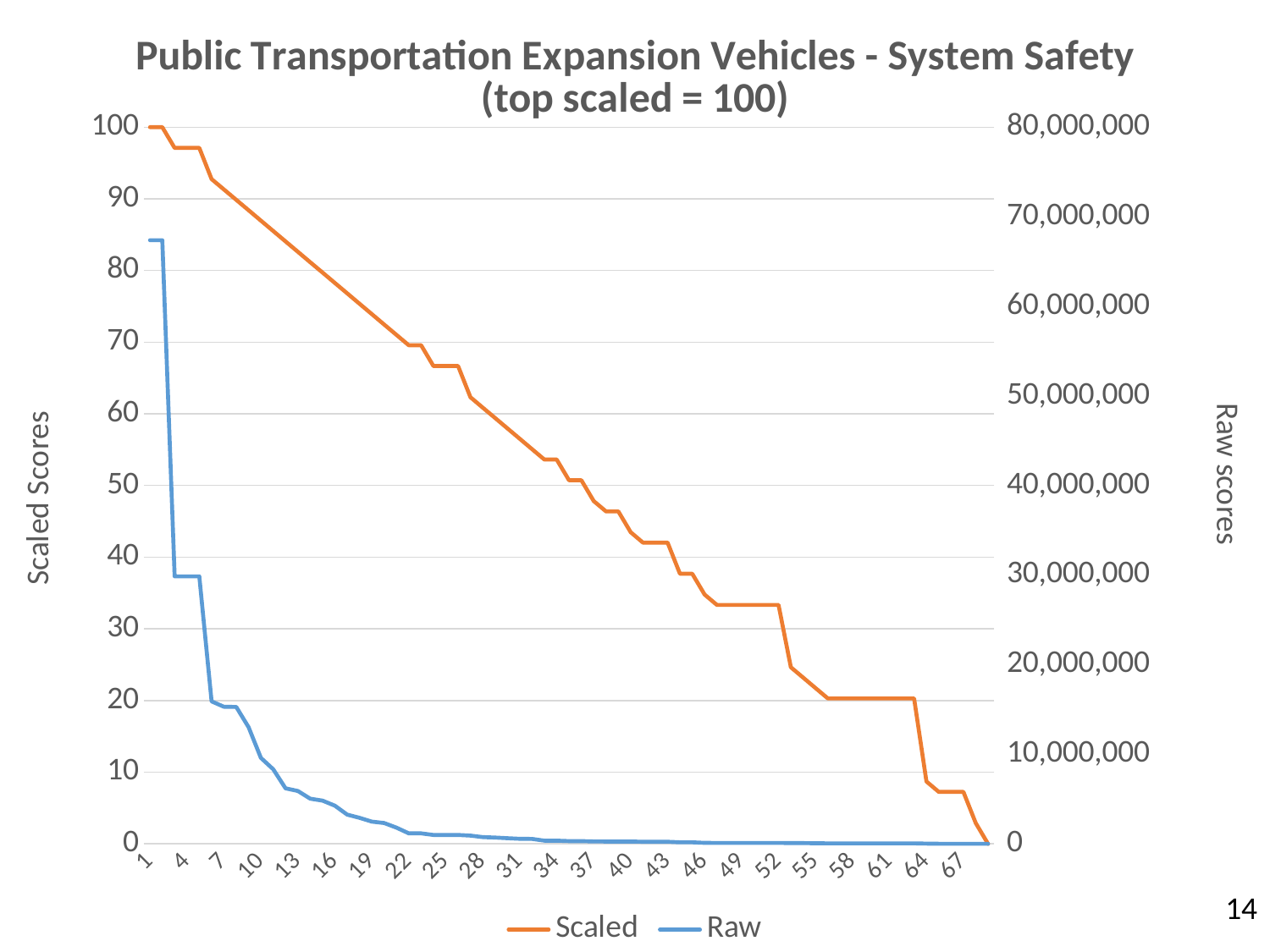
Which is larger, the Scaled value at x = 10 or the Scaled value at x = 40? x = 10 Is the Scaled value at x = 10 greater or less than 80? greater What is the Scaled value at x = 1? 100 Do the Scaled values rise or fall as you move along the x axis from 1 to 67? fall Is the Scaled value at x = 55 greater or less than 30? less Is the Raw value at x = 1 greater or less than 60,000,000? greater What kind of chart is shown on the slide? line chart Do the Raw values rise or fall as you move along the x axis? fall How many series does the legend list? 2 Which series is drawn in orange? Scaled What is the title of the right-hand vertical axis? Raw scores